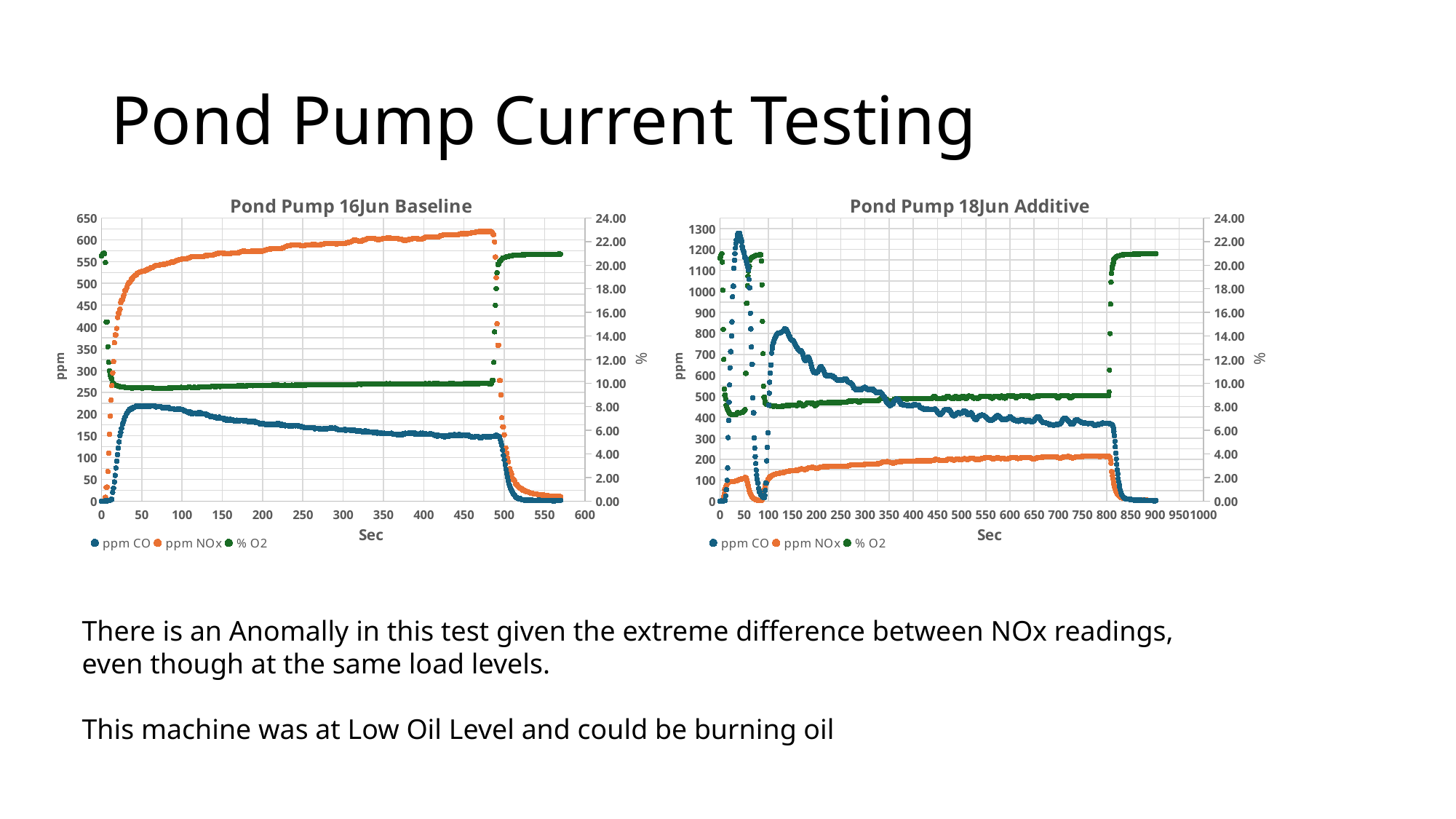
In the Pond Pump 18Jun Additive chart, is the ppm NOx value at 600 sec greater or less than 300? less In the Pond Pump 18Jun Additive chart, is the % O2 value at 500 sec greater or less than 12.00? less In the Pond Pump 18Jun Additive chart, how many series does the legend list? 3 In the Pond Pump 16Jun Baseline chart, what is the label of the x axis? Sec In the Pond Pump 16Jun Baseline chart, is the ppm CO value at 400 sec greater or less than 200? less What is the title of the chart on the left? Pond Pump 16Jun Baseline In the Pond Pump 16Jun Baseline chart, does the ppm CO series rise or fall between 100 sec and 450 sec? fall In the Pond Pump 18Jun Additive chart, which series has the larger value at 500 sec, ppm CO or ppm NOx? ppm CO In the Pond Pump 16Jun Baseline chart, which series has the larger value at 300 sec, ppm NOx or ppm CO? ppm NOx What kind of chart is the Pond Pump 16Jun Baseline chart? Scatter chart